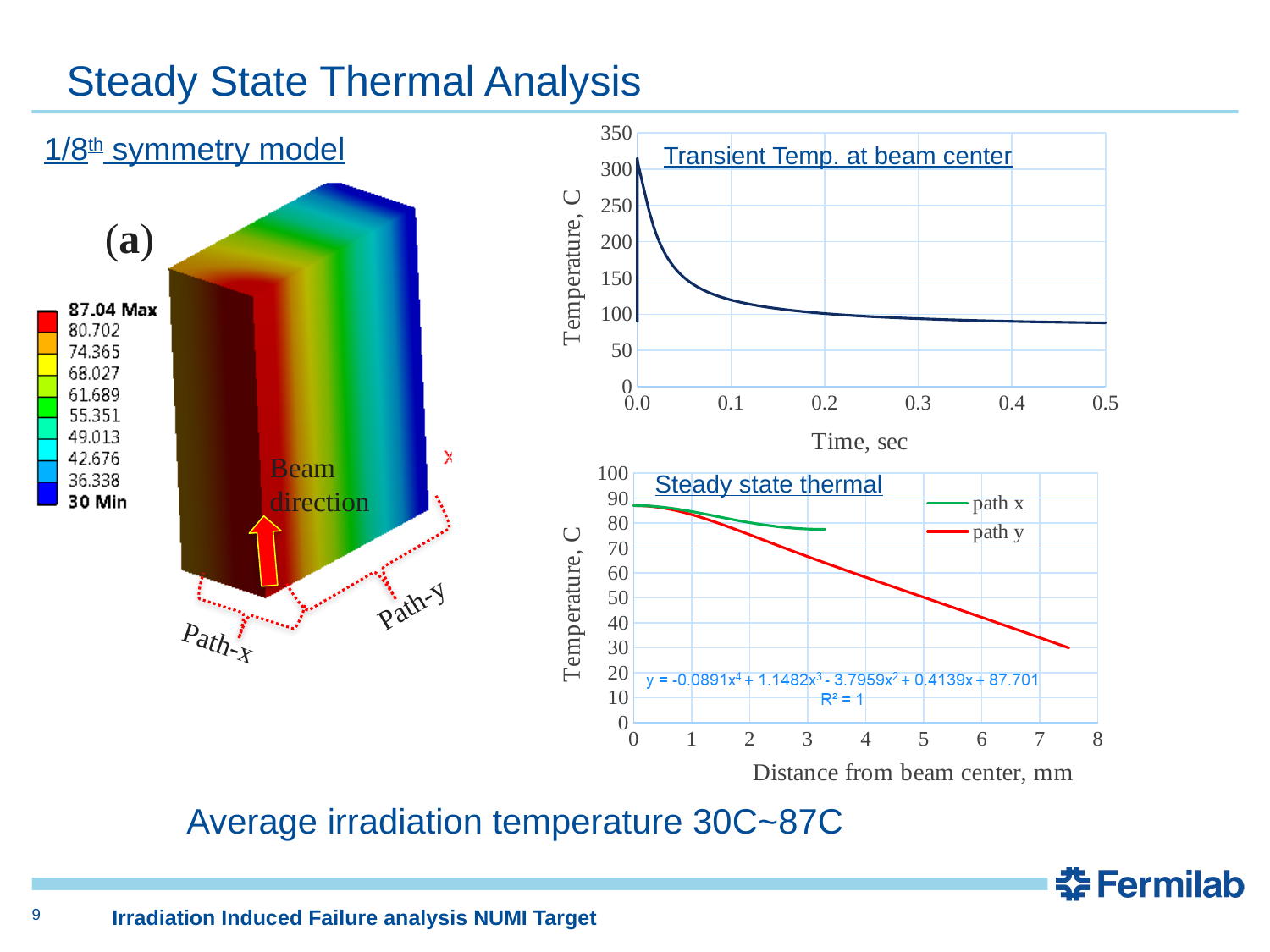
In the 'Transient Temp. at beam center' chart, does the temperature rise or fall as time increases? fall In the 'Steady state thermal' chart, does the temperature along path y rise or fall with distance from beam center? fall In the 'Transient Temp. at beam center' chart, is the peak temperature greater or less than 300? greater What kind of chart is the 'Transient Temp. at beam center' chart? line chart What are the legend entries in the 'Steady state thermal' chart? path x, path y What kind of chart is the 'Steady state thermal' chart? line chart What R² value is printed on the 'Steady state thermal' chart? R² = 1 In the 'Steady state thermal' chart, is the path y temperature at 7.5 mm greater or less than 40? less In the 'Transient Temp. at beam center' chart, is the temperature at 0.5 sec greater or less than 150? less What is the x-axis label of the 'Transient Temp. at beam center' chart? Time, sec How many series does the legend of the 'Steady state thermal' chart list? 2 In the 'Steady state thermal' chart, at a distance of 3 mm, which series has the higher temperature, path x or path y? path x